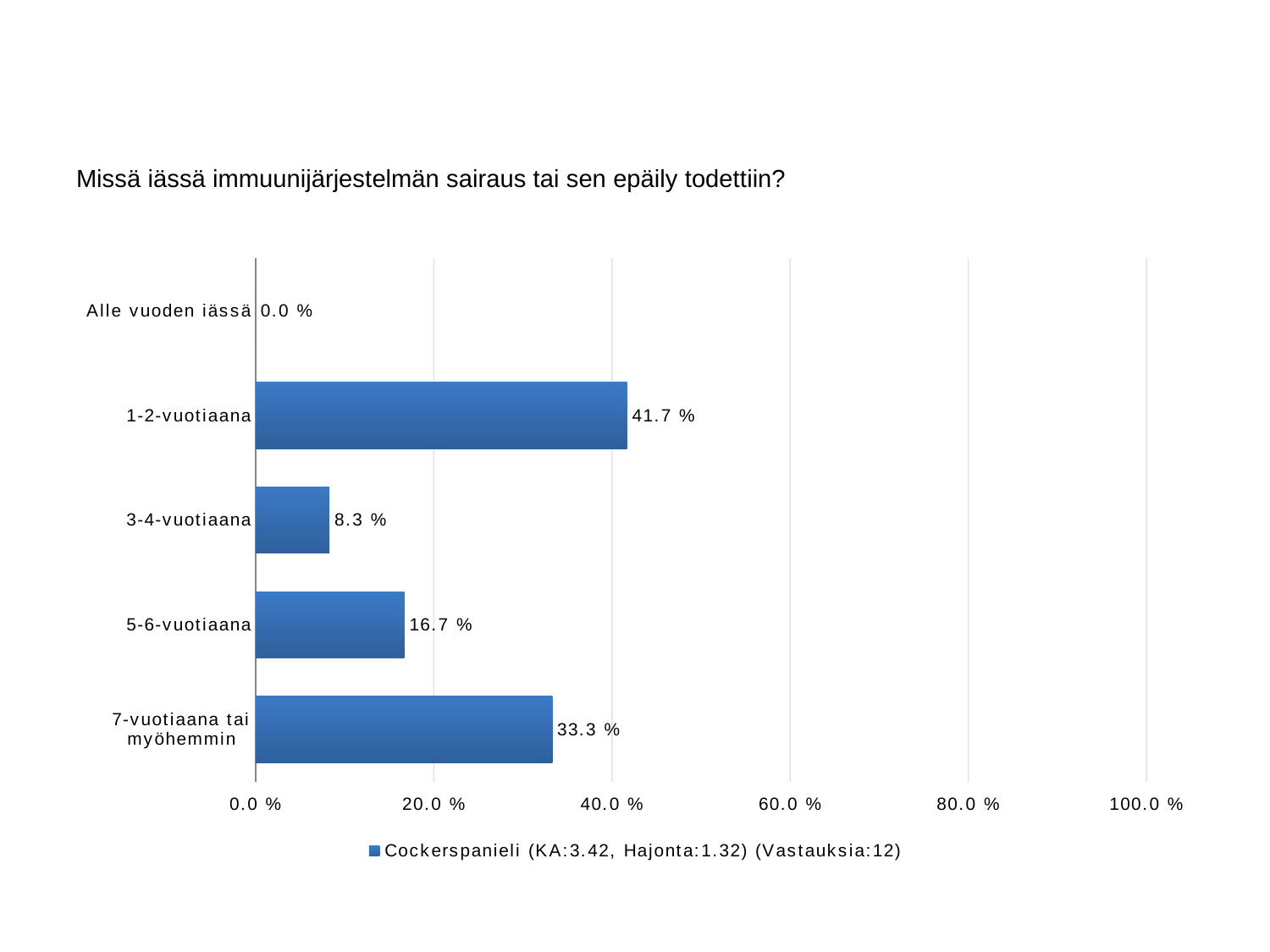
What is the difference between the values for 1-2-vuotiaana and 7-vuotiaana tai myöhemmin? 8.4 % How many responses (Vastauksia) does the legend entry report? 12 What is the value for 1-2-vuotiaana? 41.7 % What is the value for 3-4-vuotiaana? 8.3 % Is the value for 1-2-vuotiaana greater or less than 40.0 %? greater What kind of chart is shown on the slide? bar chart What is the value for Alle vuoden iässä? 0.0 % Which category has the lowest value? Alle vuoden iässä What is the value for 7-vuotiaana tai myöhemmin? 33.3 % Which category has the highest value? 1-2-vuotiaana How many categories are shown on the chart? 5 Which is larger, the value for 5-6-vuotiaana or the value for 3-4-vuotiaana? 5-6-vuotiaana